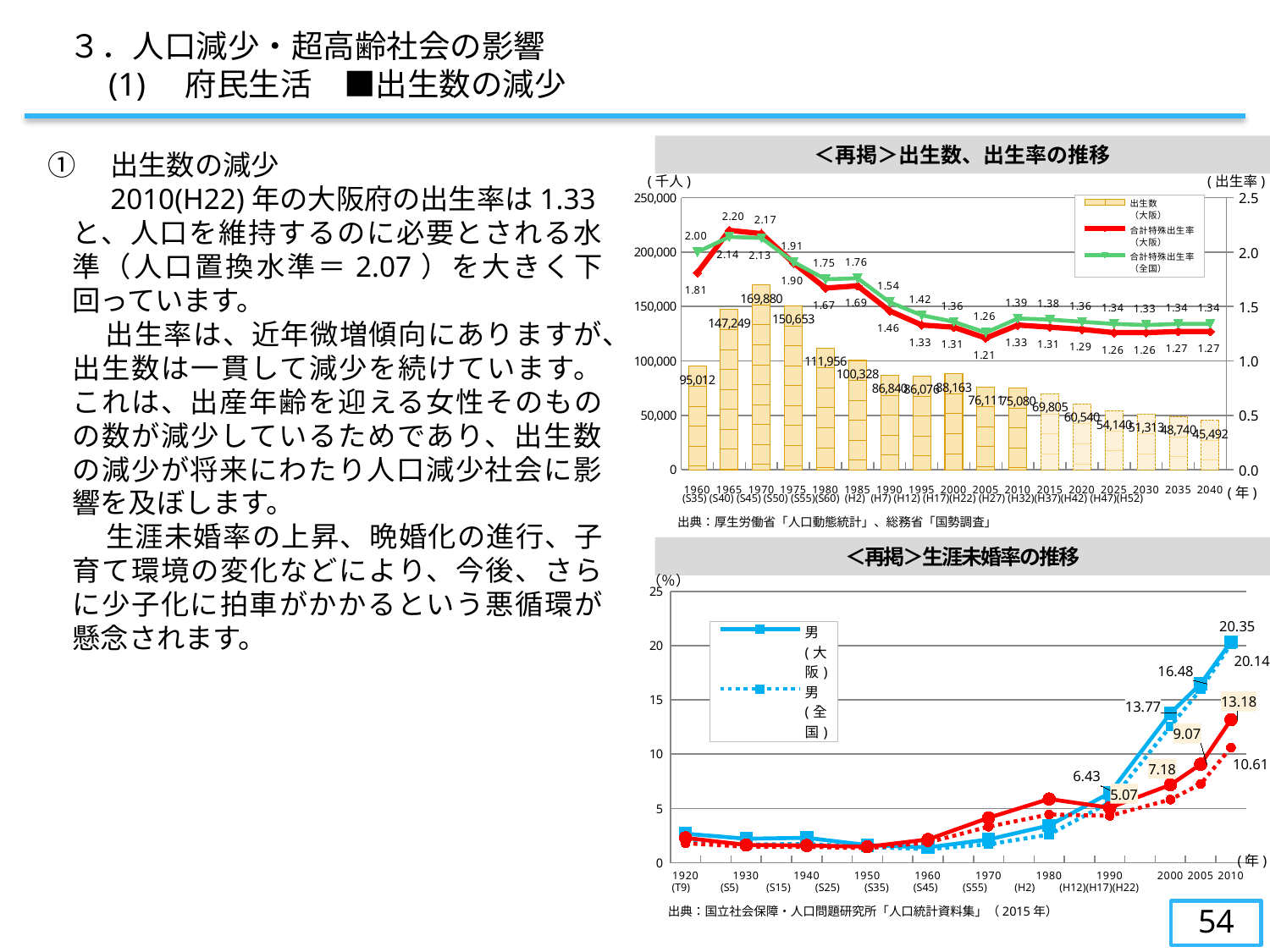
In the bottom chart (生涯未婚率の推移), is the 男（大阪） value for 1990 greater or less than 5? greater In the top chart (出生数、出生率の推移), which year has the lowest number of births? 2040 In the top chart (出生数、出生率の推移), what is the Osaka total fertility rate (合計特殊出生率（大阪）) for 2010? 1.33 In the bottom chart (生涯未婚率の推移), what is the difference between the 男（大阪） values for 2010 and 2005? 3.87 In the top chart (出生数、出生率の推移), what is the difference between the number of births in 1960 and in 2040? 49,520 In the bottom chart (生涯未婚率の推移), what is the value for 男（大阪） in 2010? 20.35 What kind of chart is the bottom chart (生涯未婚率の推移)? Line chart In the top chart (出生数、出生率の推移), which is higher in 2010: the Osaka fertility rate or the national fertility rate? National (全国), 1.39 In the top chart (出生数、出生率の推移), do the number of births rise or fall from 1970 to 2040? Fall In the top chart (出生数、出生率の推移), which year has the highest number of births? 1970 In the top chart (出生数、出生率の推移), what is the number of births (出生数) shown for 1970? 169,880 In the top chart (出生数、出生率の推移), how many series does the legend list? 3